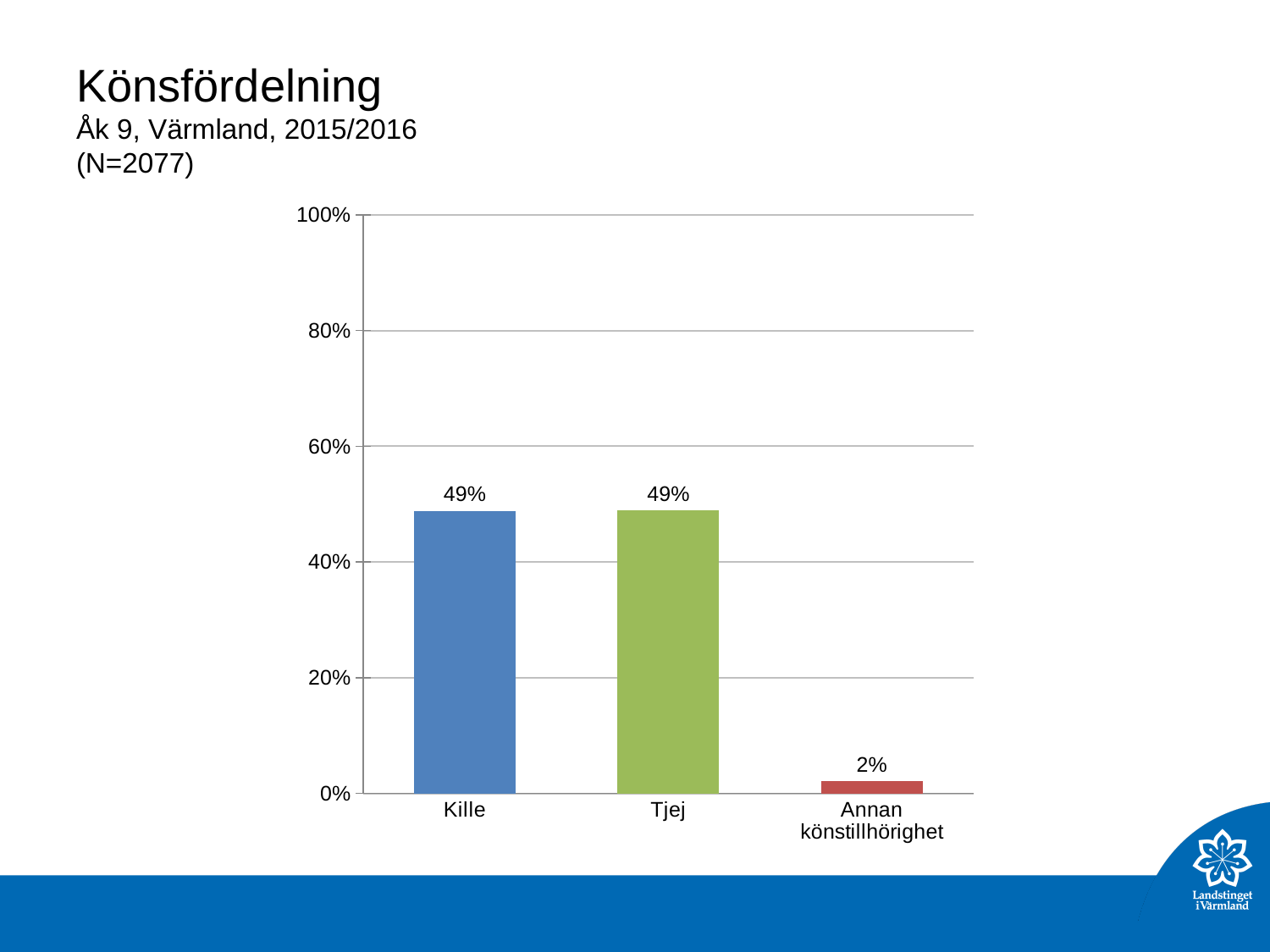
Is the value for Kille greater or less than 40%? greater How many categories are shown on the x axis? 3 Which is larger, the value for Tjej or the value for Annan könstillhörighet? Tjej What kind of chart is shown on the slide? Bar chart What is the difference between the values for Kille and Annan könstillhörighet? 47% What is the sample size (N) stated on the slide? 2077 What is the title of the slide? Könsfördelning What is the value for Tjej? 49% Which category has the lowest value? Annan könstillhörighet Is the value for Annan könstillhörighet greater or less than 20%? less What is the value for Kille? 49% What is the value for Annan könstillhörighet? 2%